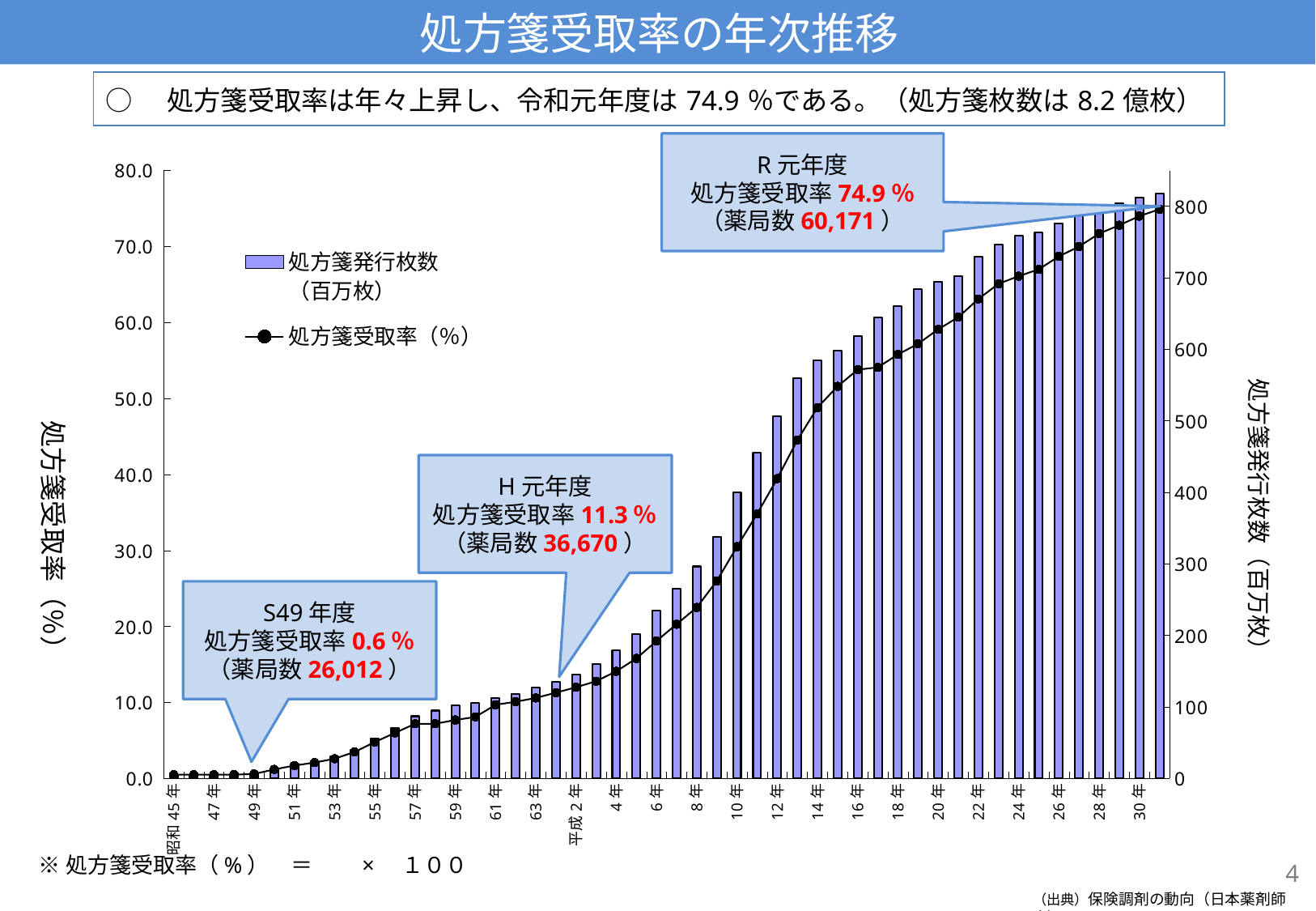
What is the 薬局数 given for R元年度? 60,171 What is the 処方箋受取率 for S49年度 shown in the callout? 0.6 % What is the 処方箋受取率 for H元年度 shown in the callout? 11.3 % How many series does the legend list? 2 Which year has the higher 処方箋受取率, H元年度 or R元年度? R元年度 What is the difference in 処方箋受取率 between H元年度 and S49年度? 10.7 % What is the 薬局数 given for H元年度? 36,670 Does the 処方箋受取率 rise or fall over the years along the x axis? rise What is the 処方箋受取率 for R元年度 shown in the callout? 74.9 % What is the difference in 処方箋受取率 between R元年度 and H元年度? 63.6 % Is the 処方箋受取率 for 平成6年 greater or less than 20.0? less Is the 処方箋発行枚数 bar for 平成20年 greater or less than 600? greater